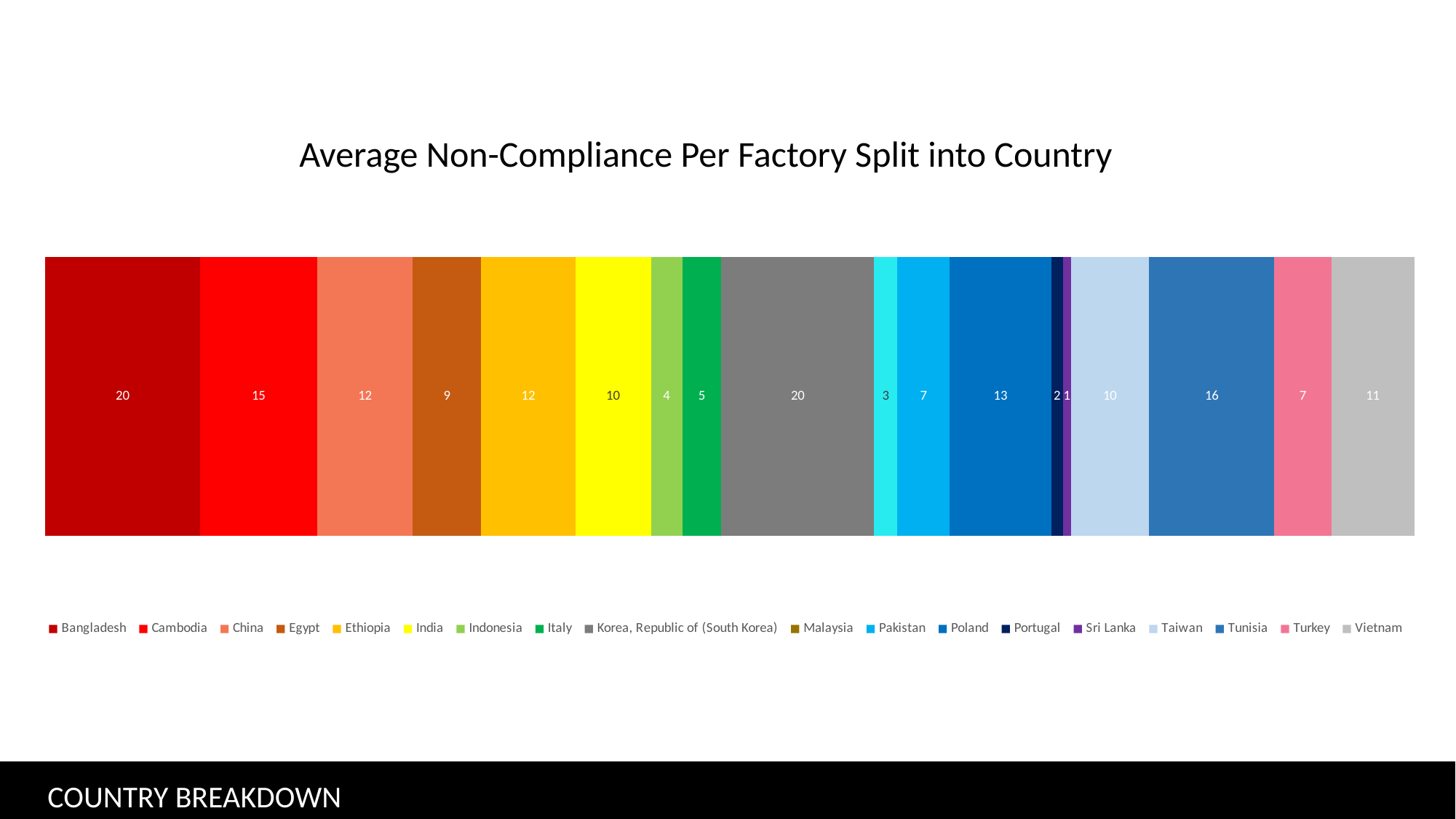
Which is larger, the value for Vietnam or the value for Taiwan? Vietnam How many countries does the legend list? 18 What is the value for Poland? 13 What is the value for Egypt? 9 Which is larger, the value for Indonesia or the value for Turkey? Turkey What kind of chart is shown? Stacked bar chart What is the total of all the segments in the stacked bar? 177 What is the value for Bangladesh? 20 Which country has the lowest value? Sri Lanka What is the difference between the values for Cambodia and Italy? 10 What is the title of the chart? Average Non-Compliance Per Factory Split into Country What is the value for Tunisia? 16